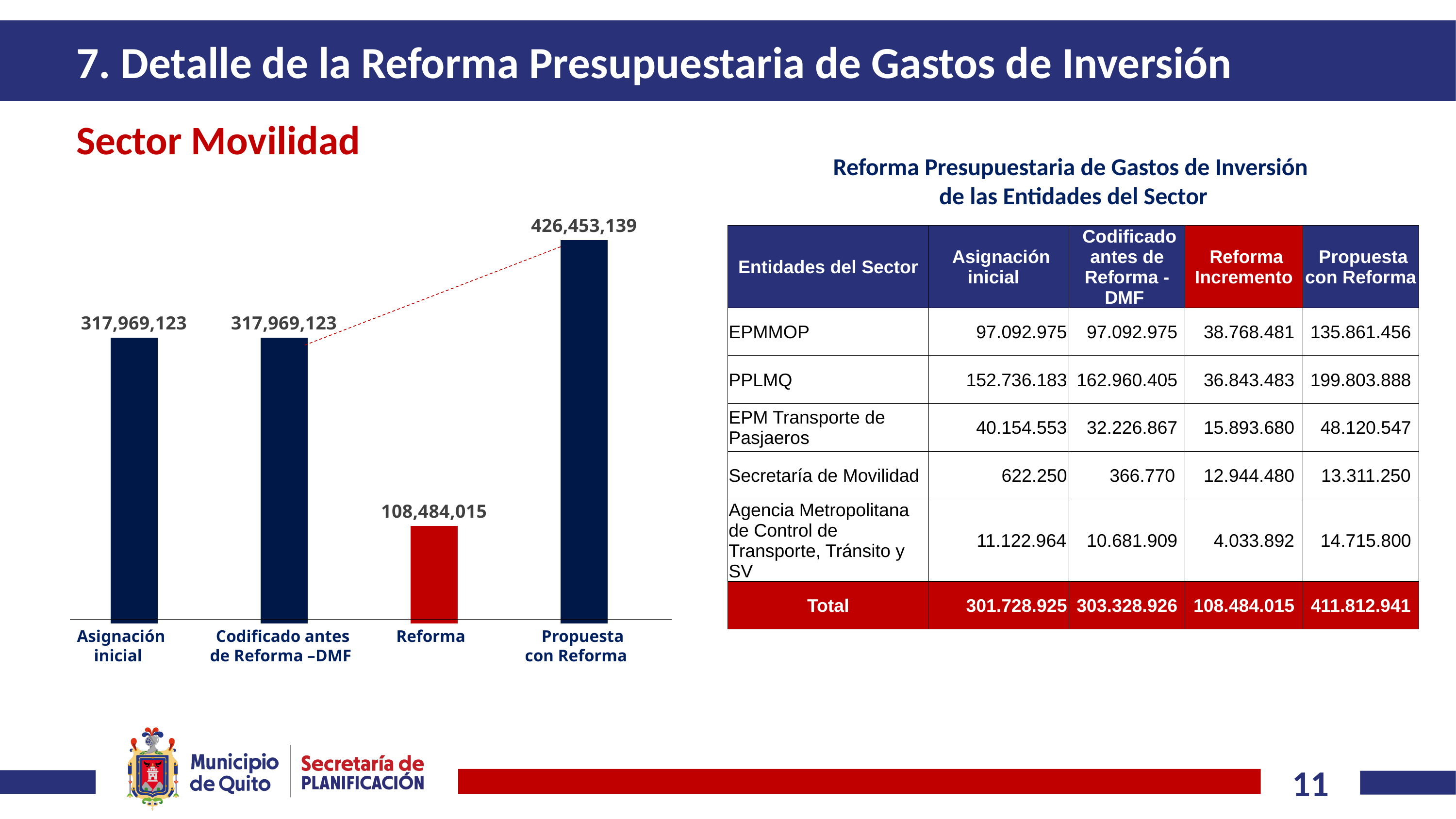
What is the value of the Propuesta con Reforma bar in the chart? 426,453,139 Which category has the lowest value in the chart? Reforma Which bar in the chart is coloured red rather than dark blue? Reforma What is the value of the Asignación inicial bar in the chart? 317,969,123 What type of chart is shown on the slide? Bar chart What is the difference between the Asignación inicial bar and the Reforma bar? 209,485,108 What is the value of the Reforma bar in the chart? 108,484,015 Which is larger in the chart, Reforma or Propuesta con Reforma? Propuesta con Reforma How many bars are shown in the chart? 4 What is the difference between the Propuesta con Reforma bar and the Codificado antes de Reforma –DMF bar? 108,484,016 Which category has the highest value in the chart? Propuesta con Reforma What is the value of the Codificado antes de Reforma –DMF bar in the chart? 317,969,123